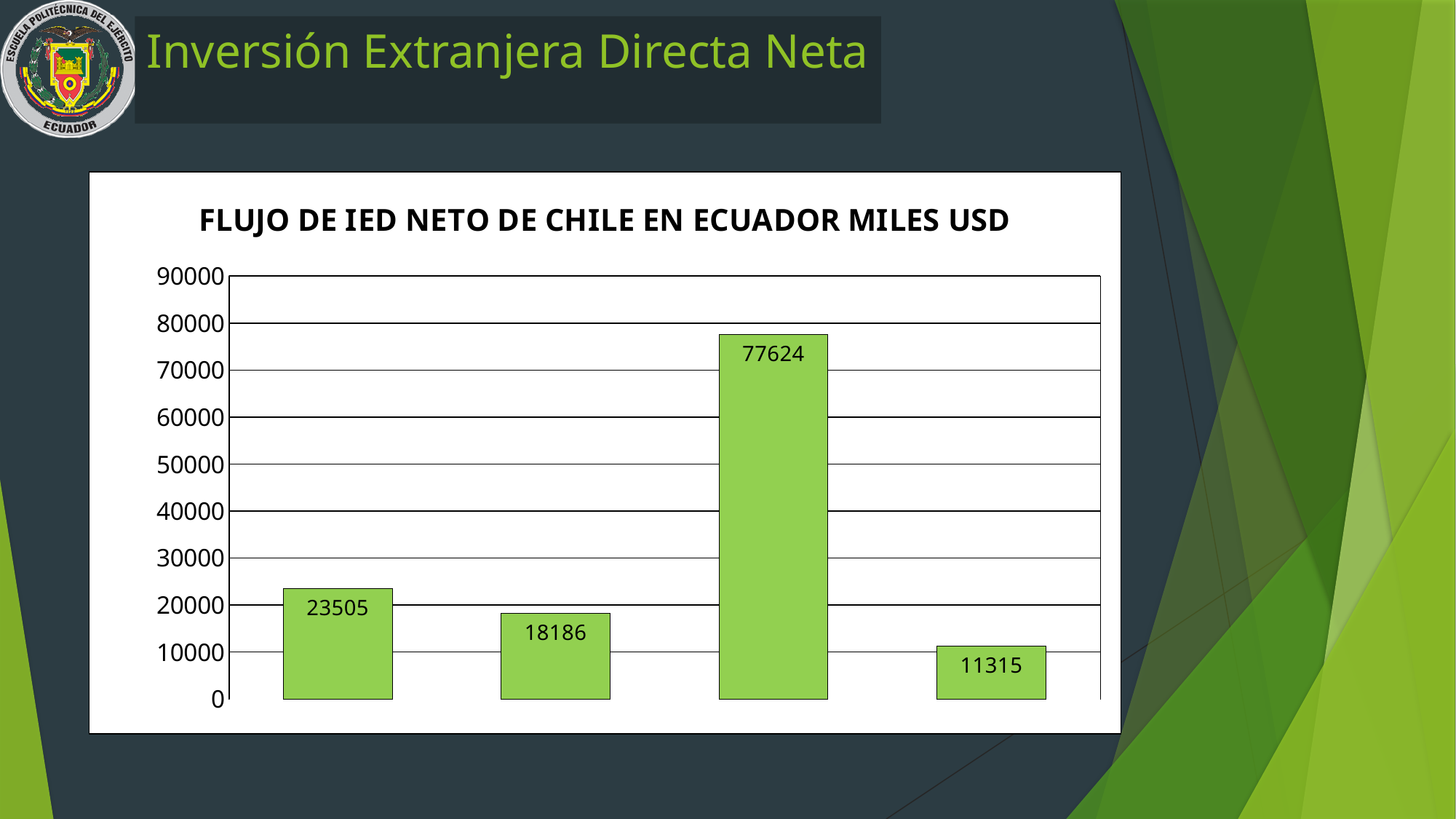
What is the value shown on the second bar from the left? 18186 What type of chart is shown on the slide? bar chart Does the value fall or rise from the third bar to the fourth bar? fall Which is larger, the value of the first bar or the value of the second bar? the first bar (23505) What is the value shown on the third bar from the left? 77624 What is the difference between the third bar (77624) and the first bar (23505)? 54119 What is the value shown on the first (leftmost) bar? 23505 What is the highest value plotted in the chart? 77624 What is the lowest value plotted in the chart? 11315 What is the value shown on the fourth (rightmost) bar? 11315 What is the title of the chart? FLUJO DE IED NETO DE CHILE EN ECUADOR MILES USD How many bars are plotted in the chart? 4